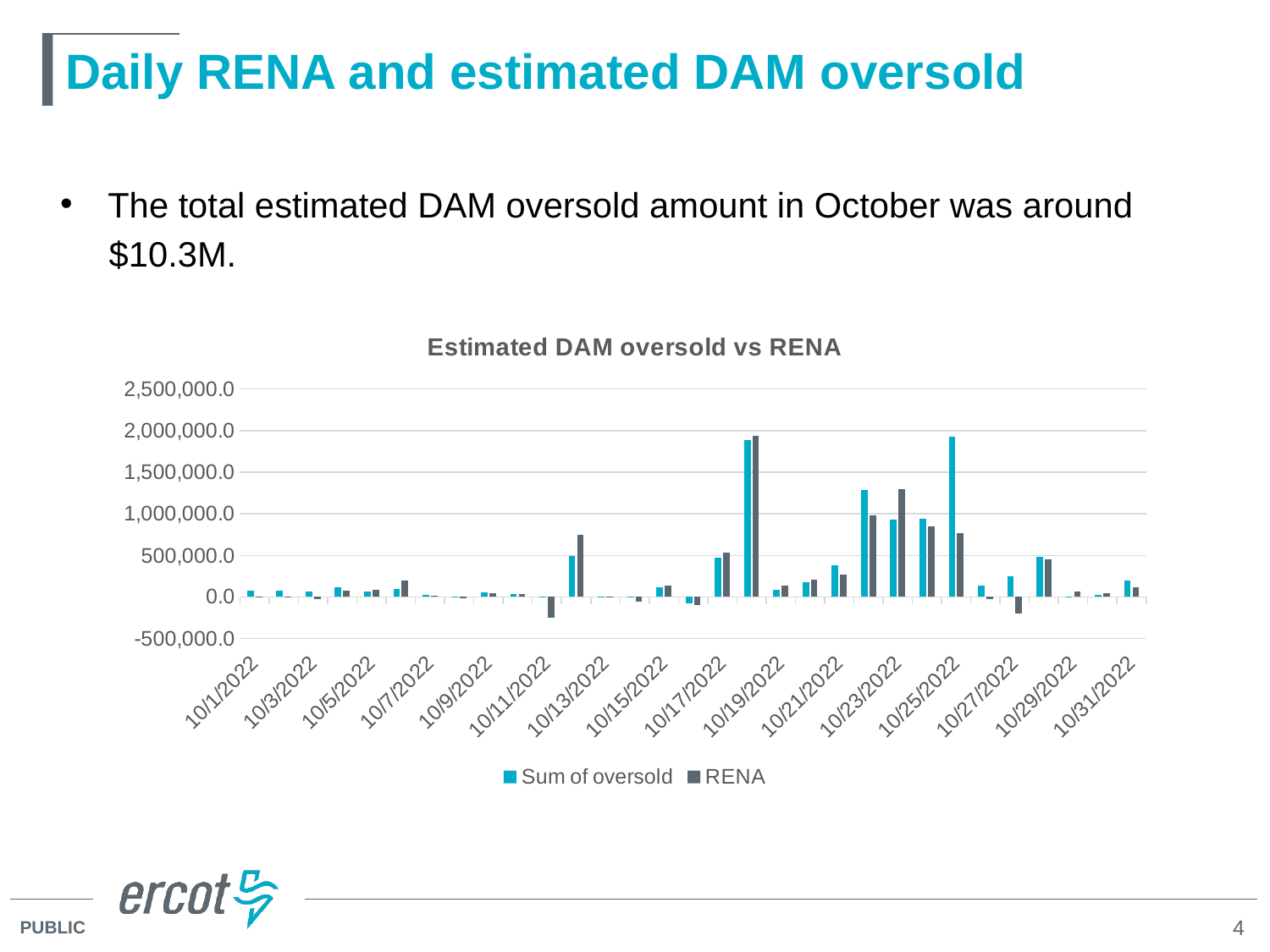
What are the two series named in the chart legend? Sum of oversold and RENA Is the Sum of oversold value for 10/18/2022 greater or less than 1,500,000.0? greater How many date labels are shown along the x axis of the chart? 16 On 10/12/2022, which is larger: Sum of oversold or RENA? RENA Is the RENA value for 10/25/2022 greater or less than 1,000,000.0? less What kind of chart is shown on the slide? Bar chart How many series does the chart legend list? 2 What is the title of the chart? Estimated DAM oversold vs RENA Is the RENA value for 10/11/2022 greater or less than 0.0? less On which date is the RENA value highest? 10/18/2022 On 10/25/2022, which is larger: Sum of oversold or RENA? Sum of oversold